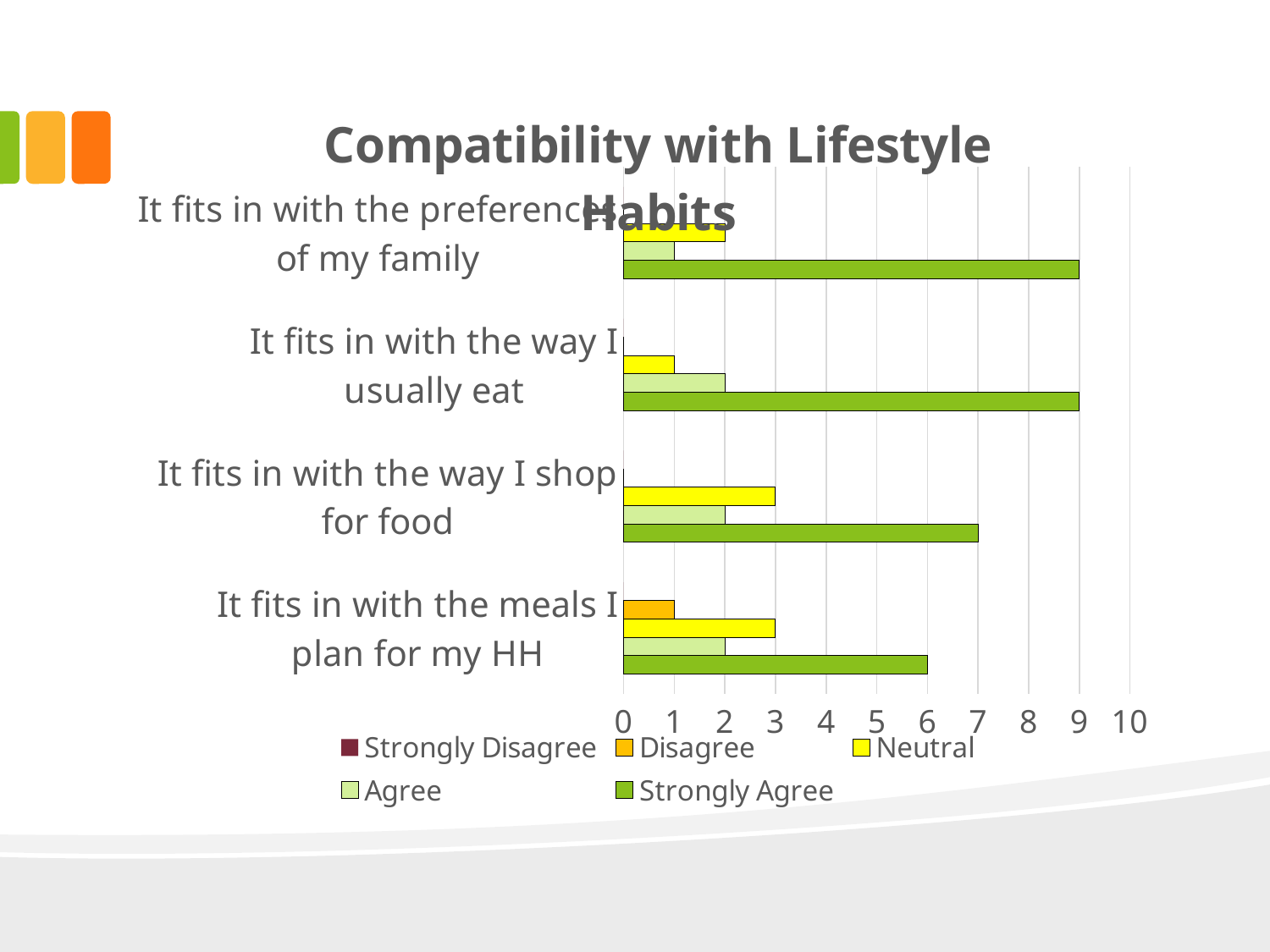
Which is larger for "It fits in with the way I shop for food": the Neutral value or the Agree value? Neutral How many series does the legend list? 5 What is the difference between the Strongly Agree values for "It fits in with the way I shop for food" and "It fits in with the meals I plan for my HH"? 1 How many categories are shown on the chart? 4 What is the Strongly Agree value for "It fits in with the meals I plan for my HH"? 6 What is the Neutral value for "It fits in with the way I shop for food"? 3 What is the Disagree value for "It fits in with the meals I plan for my HH"? 1 Is the Strongly Agree value for "It fits in with the preferences of my family" greater or less than 5? greater What kind of chart is shown on the slide? Bar chart Which category has the lowest Strongly Agree value? It fits in with the meals I plan for my HH What is the Strongly Agree value for "It fits in with the way I usually eat"? 9 Which legend entry is shown in orange? Disagree